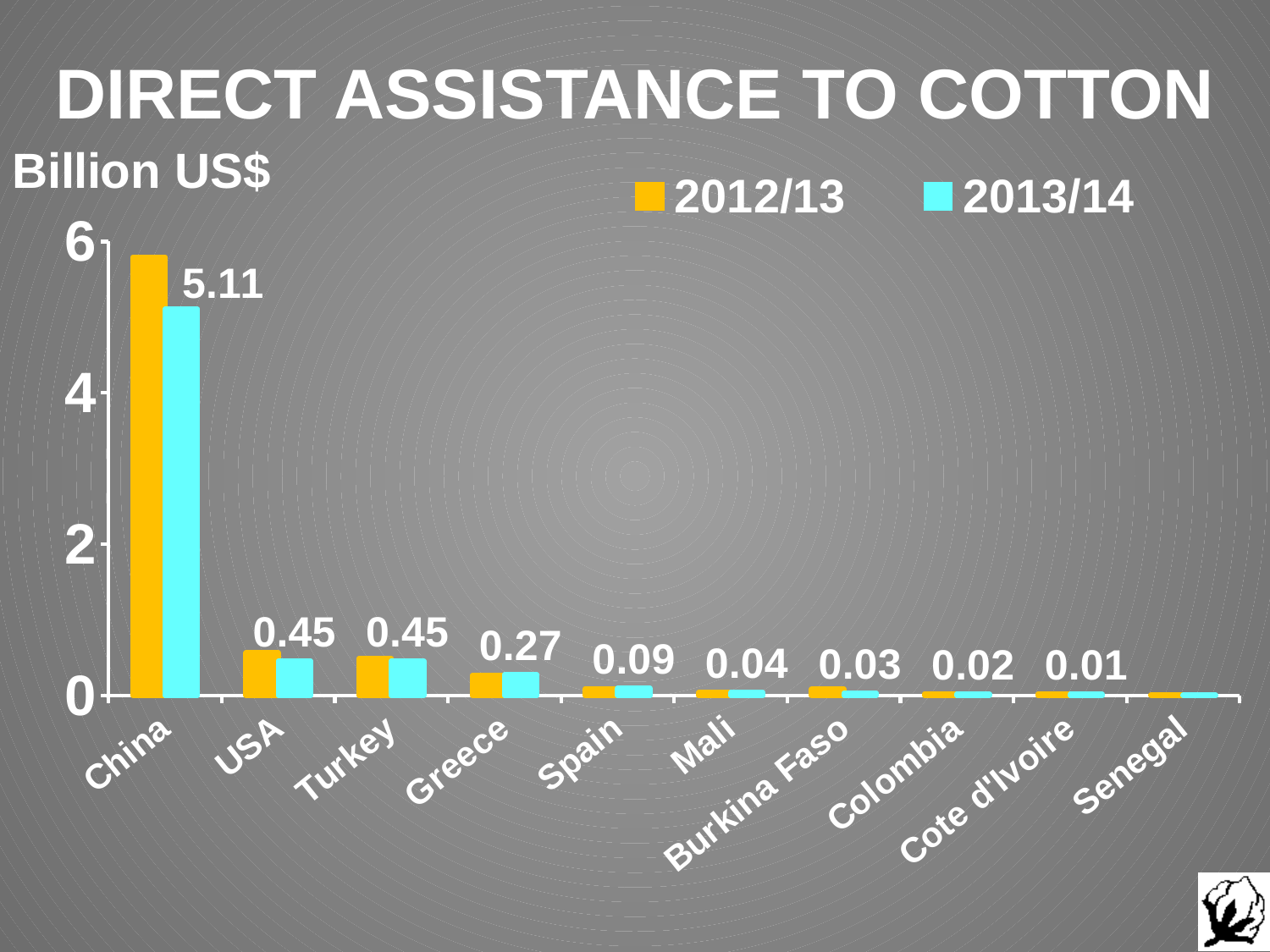
What is the 2013/14 value for Spain? 0.09 What unit is stated for the values on the chart? Billion US$ What is the 2013/14 value for Greece? 0.27 What is the 2013/14 value for China? 5.11 What is the 2013/14 value for Burkina Faso? 0.03 For China, which is larger: the 2012/13 value or the 2013/14 value? 2012/13 What kind of chart is shown on the slide? Bar chart Is the 2012/13 value for China greater or less than 4? greater What is the difference between the 2013/14 values for China and USA? 4.66 Which country has the highest direct assistance to cotton? China How many series does the legend list? 2 How many countries are shown on the x axis? 10